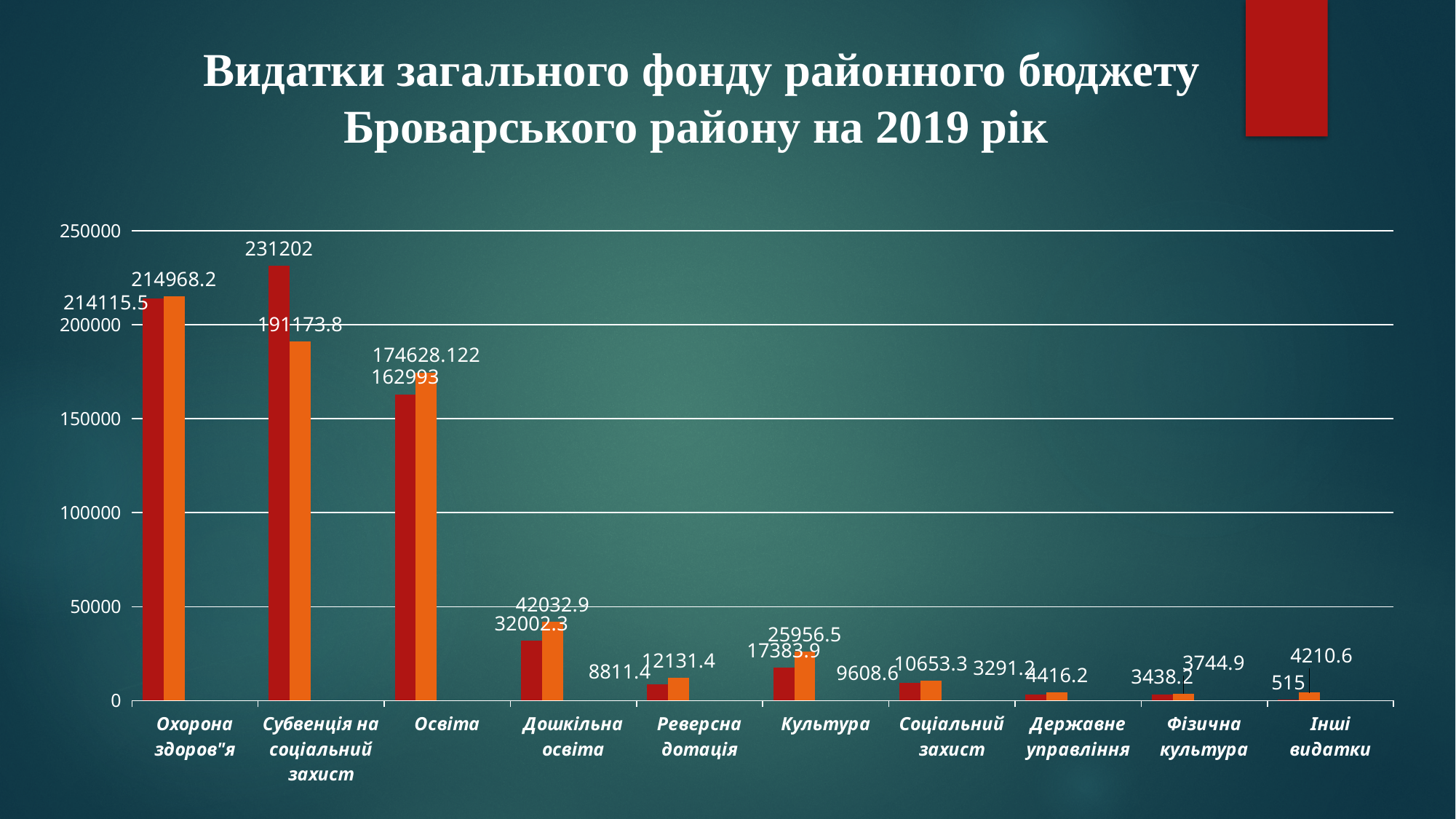
What kind of chart is shown on the slide? bar chart Is the value of the red bar for Субвенція на соціальний захист greater or less than 200000? greater What is the difference between the orange bar and the red bar for Дошкільна освіта? 10030.6 Which category has the lowest red bar? Інші видатки What is the title of the slide? Видатки загального фонду районного бюджету Броварського району на 2019 рік How many categories are shown on the x axis of the chart? 10 Which category has the highest red bar? Субвенція на соціальний захист What is the difference between the orange bar and the red bar for Культура? 8572.6 What is the value of the red bar for Освіта? 162993 What is the value of the orange bar for Інші видатки? 4210.6 For Освіта, which bar is larger, the red one or the orange one? the orange one What is the value of the orange bar for Дошкільна освіта? 42032.9